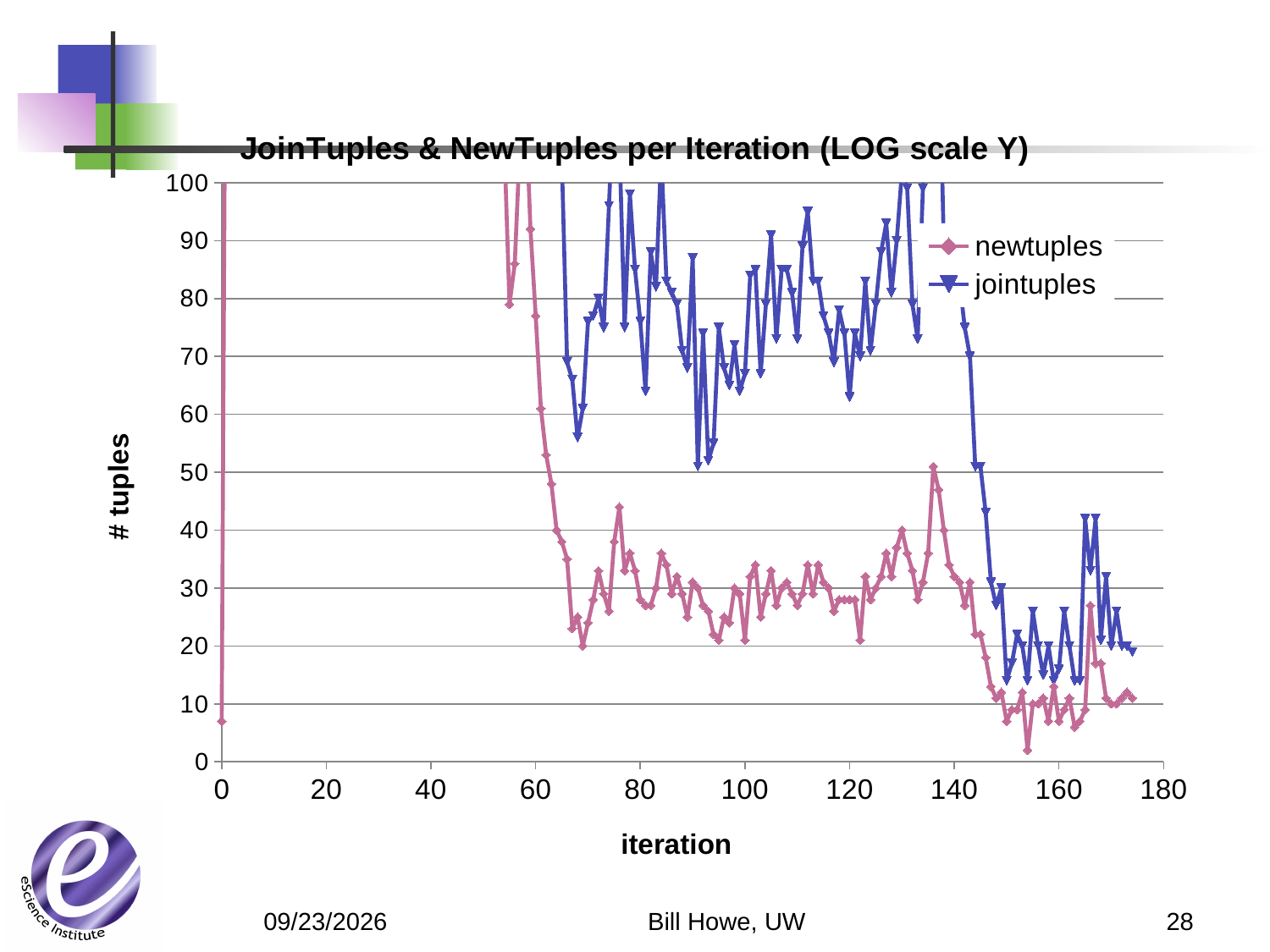
How many series does the legend list? 2 Is the value of jointuples at iteration 100 greater or less than 50? greater Does the jointuples series rise or fall between iteration 140 and iteration 150? fall At iteration 100, which series has the higher value, newtuples or jointuples? jointuples Does the newtuples series rise or fall between iteration 60 and iteration 70? fall At iteration 160, which series has the higher value, newtuples or jointuples? jointuples What is the title of the chart? JoinTuples & NewTuples per Iteration (LOG scale Y) Is the value of newtuples at iteration 160 greater or less than 20? less Is the value of jointuples at iteration 170 greater or less than 50? less What are the two series named in the legend? newtuples and jointuples What kind of chart is shown on the slide? line chart